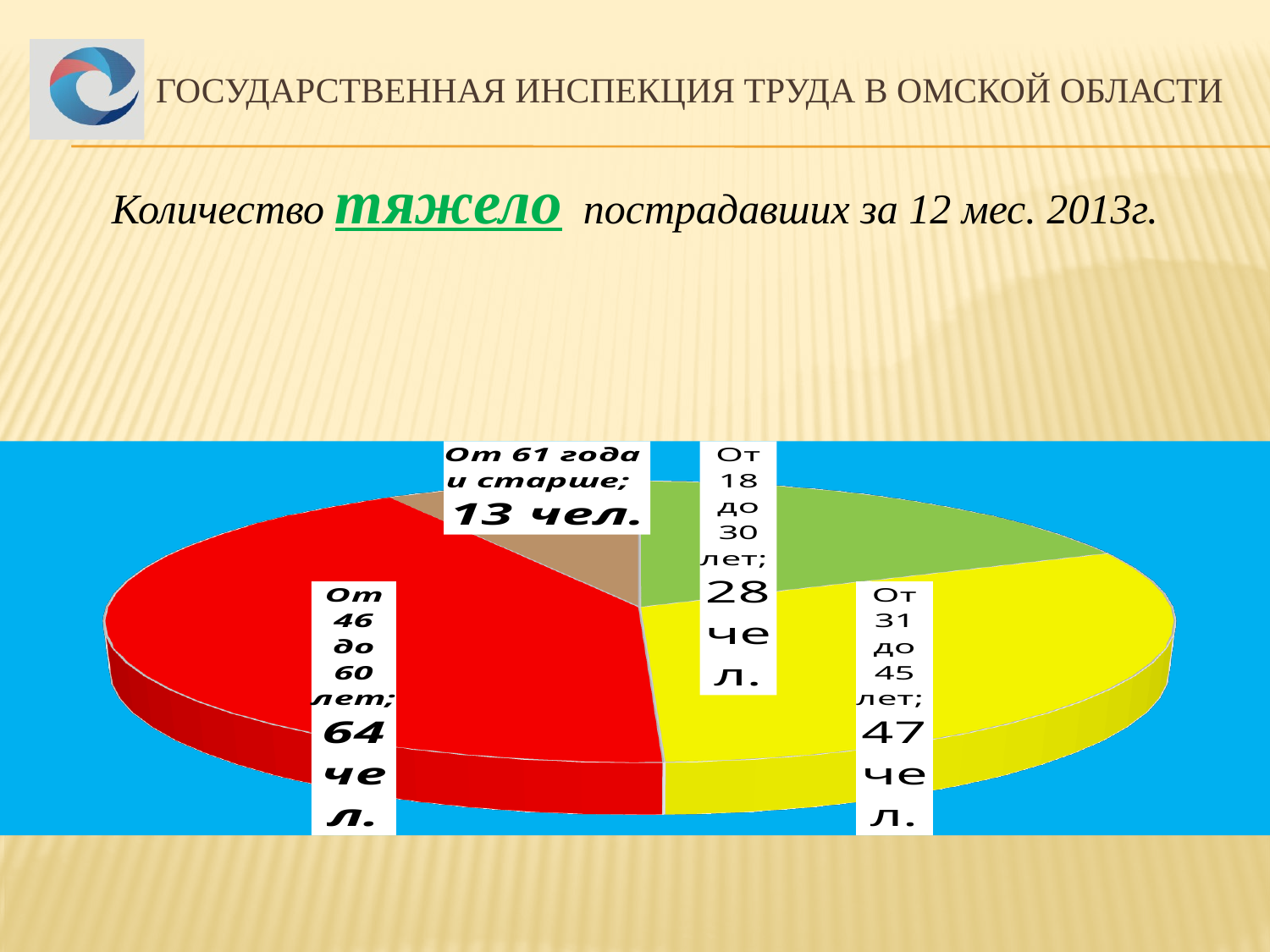
What is the difference between the values for От 46 до 60 лет and От 31 до 45 лет? 17 What is the value for the age group От 61 года и старше? 13 чел. What is the value for the age group От 31 до 45 лет? 47 чел. Which age group has the smallest number of seriously injured people? От 61 года и старше Which is larger: the value for От 18 до 30 лет or От 61 года и старше? От 18 до 30 лет How many seriously injured people aged 18 to 30 (От 18 до 30 лет) are shown? 28 чел. What is the value for the age group От 46 до 60 лет? 64 чел. How many slices does the pie chart have? 4 What is the total number of seriously injured people across all age groups in the pie chart? 152 Which age group has the largest number of seriously injured people? От 46 до 60 лет Which colour represents the age group От 46 до 60 лет in the pie chart? red What kind of chart is shown on the slide? pie chart